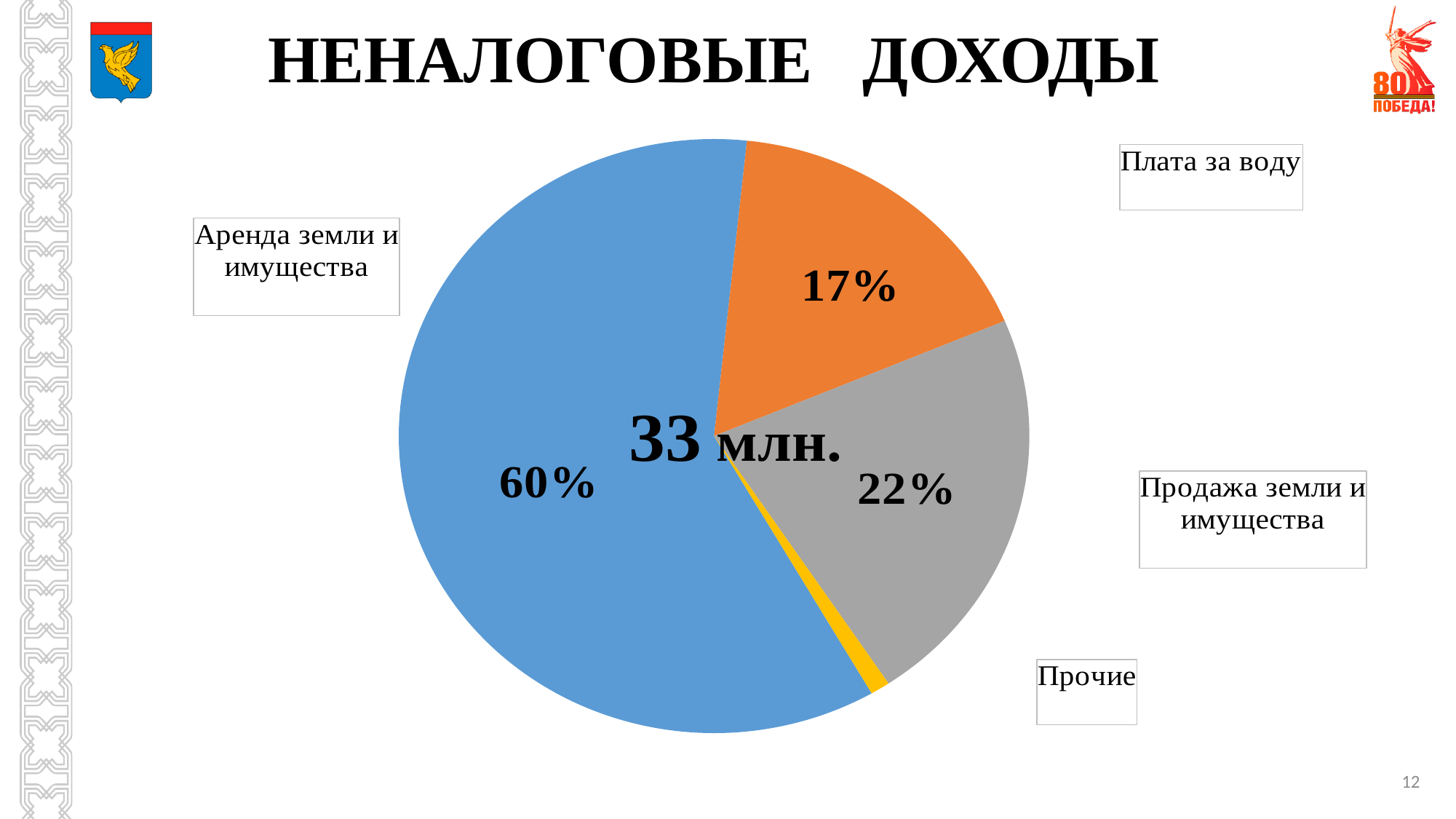
By how many percentage points does Продажа земли и имущества exceed Плата за воду? 5% What is the title of the slide? НЕНАЛОГОВЫЕ ДОХОДЫ What share of non-tax revenues comes from Аренда земли и имущества? 60% How many categories are shown in the pie chart? 4 What share does Продажа земли и имущества account for? 22% What total amount is printed in the centre of the pie chart? 33 млн. Which is larger: Плата за воду or Продажа земли и имущества? Продажа земли и имущества What percentage of the pie is Плата за воду? 17% What type of chart is shown on the slide? Pie chart By how many percentage points does Аренда земли и имущества exceed Продажа земли и имущества? 38% Which category has the smallest slice of the pie? Прочие Which category has the largest slice of the pie? Аренда земли и имущества